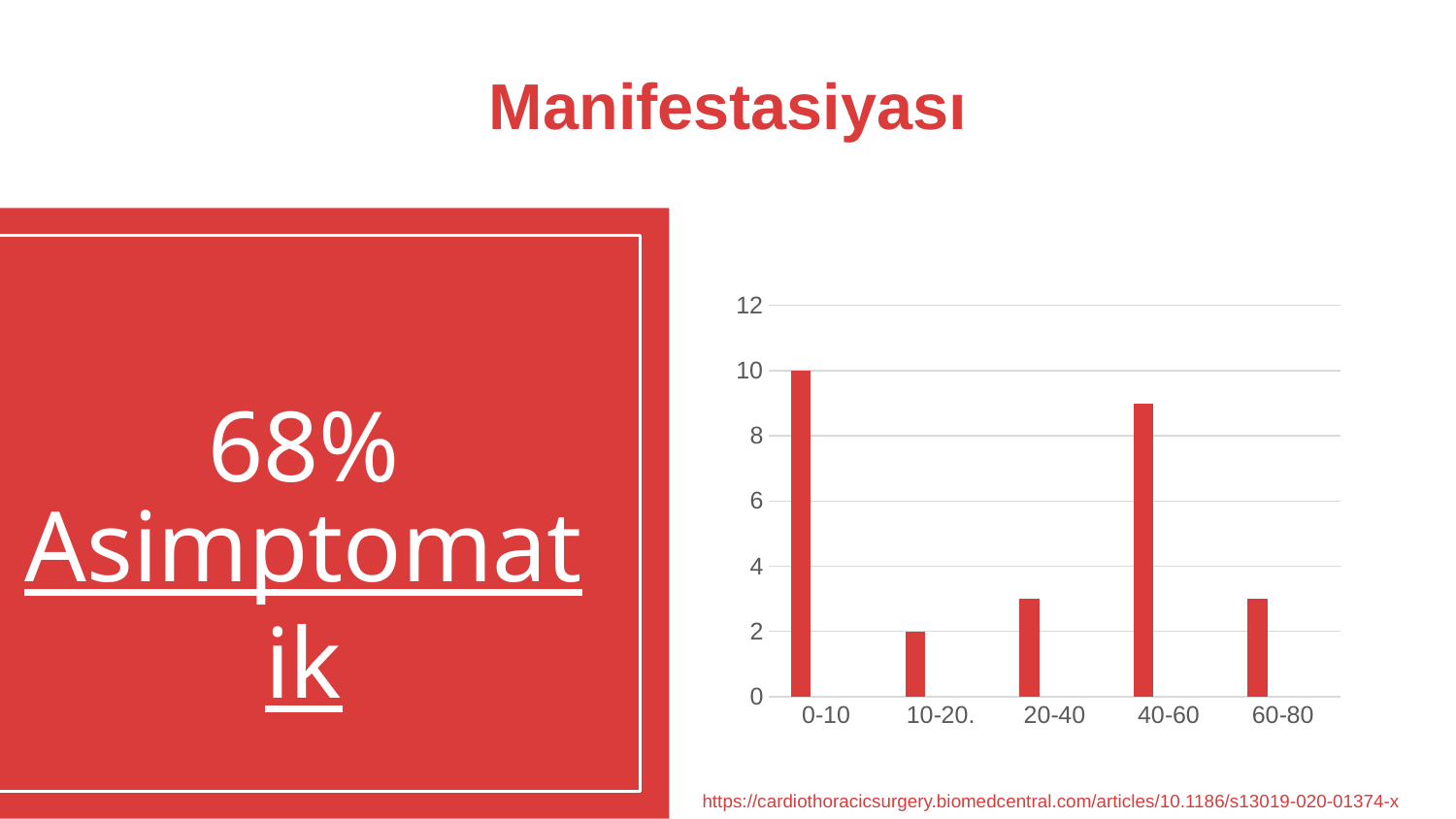
How many categories are shown on the x axis of the chart? 5 Is the value for 60-80 greater or less than 2? greater Is the value for 20-40 greater or less than 4? less Which is larger, the value for 10-20. or the value for 20-40? 20-40 What is the difference between the value for 0-10 and the value for 10-20.? 8 Which is larger, the value for 0-10 or the value for 40-60? 0-10 Which category has the highest bar? 0-10 What kind of chart is shown on the slide? bar chart What is the value for the 0-10 category? 10 Is the value for 40-60 greater or less than 8? greater What is the value for the 10-20. category? 2 Which category has the lowest bar? 10-20.